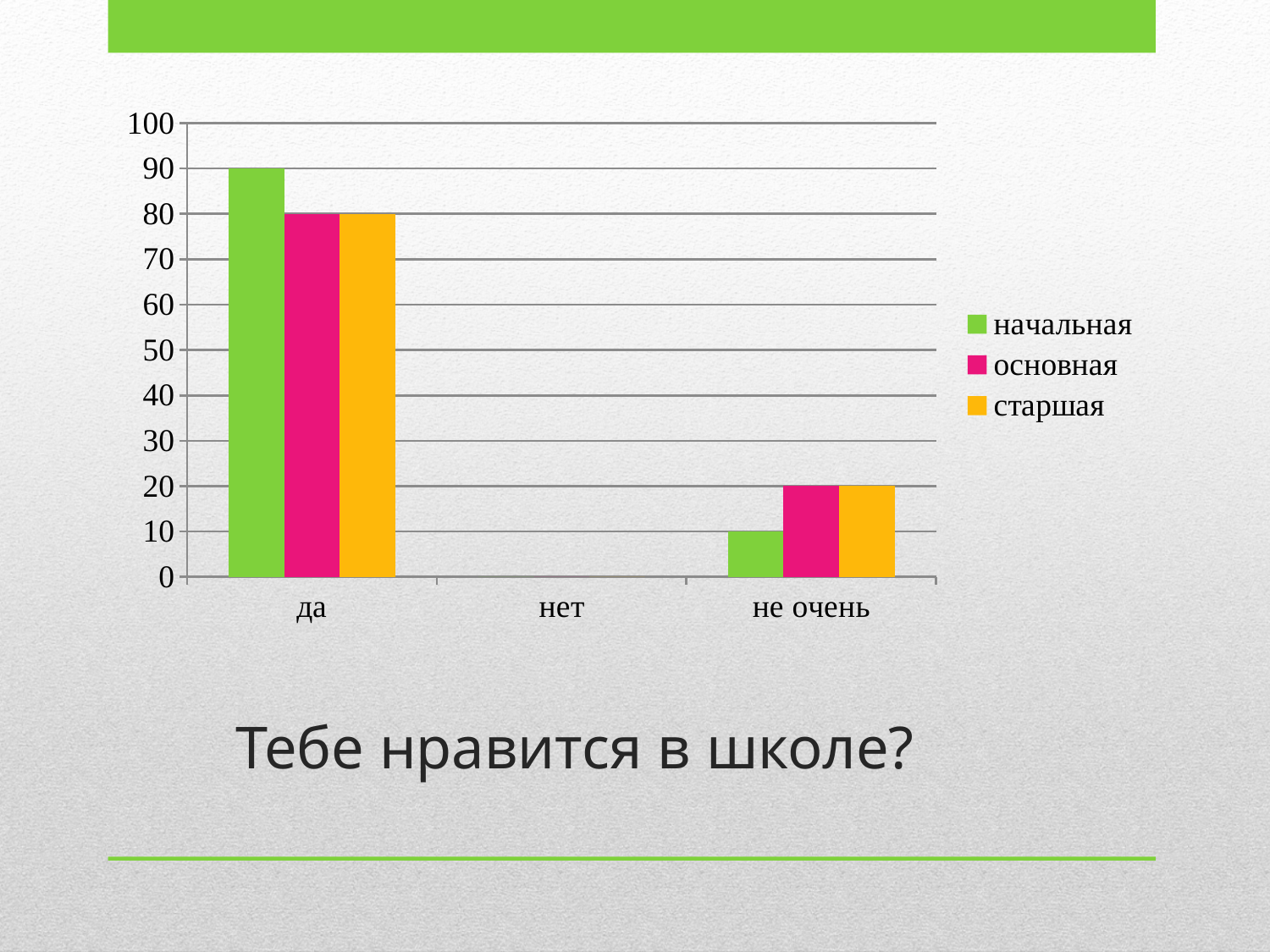
Which is larger in the category не очень: the value for начальная or the value for основная? основная What kind of chart is shown on the slide? bar chart Which series is shown in green in the legend? начальная Which category has the highest value for начальная? да Which series has the lowest value in the category не очень? начальная What is the difference between the начальная and основная values in the category да? 10 What is the value for начальная in the category не очень? 10 What is the value for начальная in the category да? 90 What is the value for старшая in the category не очень? 20 How many categories are shown on the x axis? 3 What is the value for основная in the category да? 80 How many series does the legend list? 3